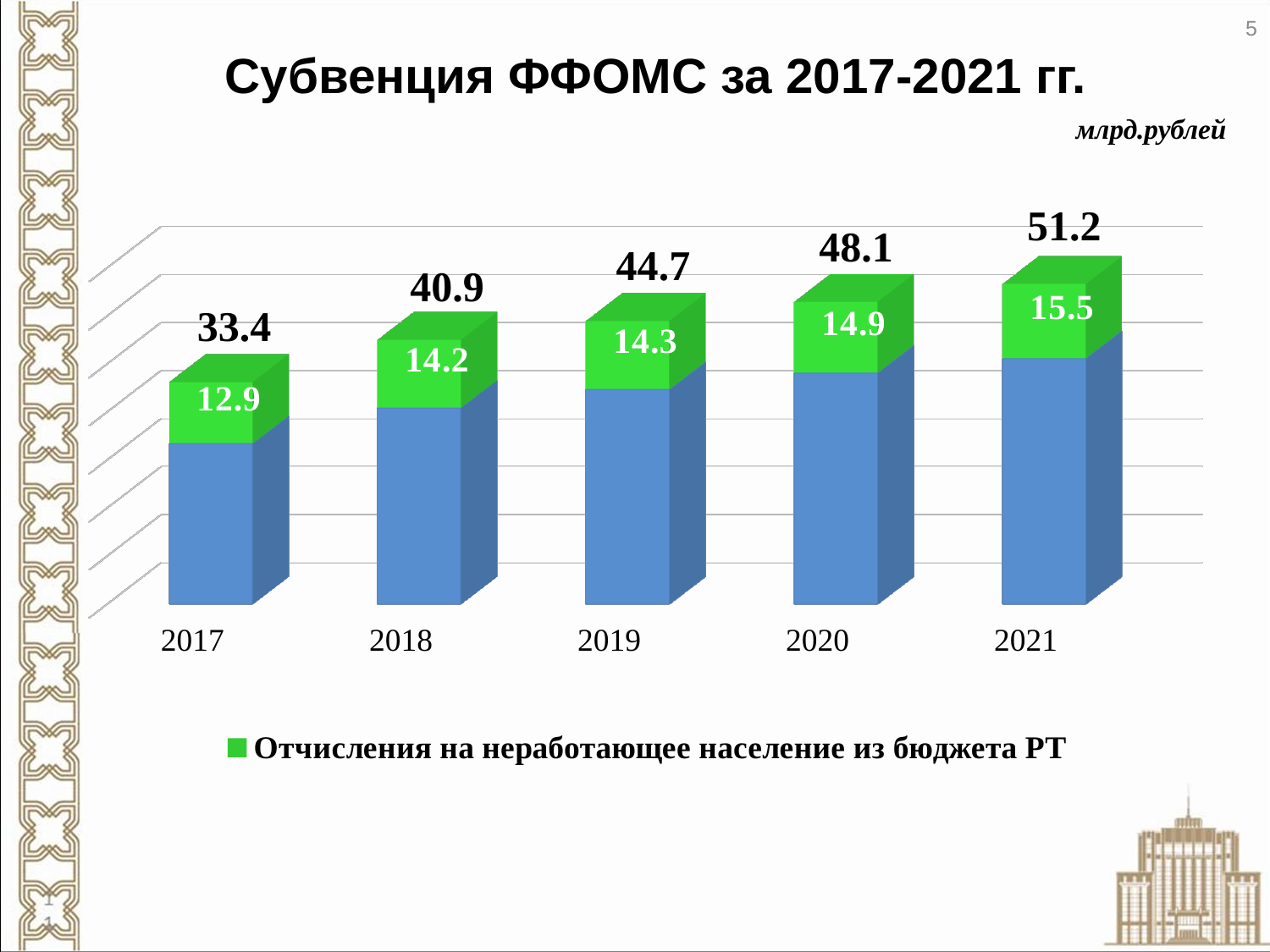
What is the value of the green segment (Отчисления на неработающее население из бюджета РТ) for 2019? 14.3 Which is larger: the total for 2018 or the total for 2019? 2019 What is the difference between the total values for 2021 and 2017? 17.8 What is the difference between the green segment values for 2021 and 2020? 0.6 How many years are shown on the x axis? 5 Which year has the lowest value for the green segment? 2017 What is the total value shown above the bar for 2017? 33.4 Do the total values rise or fall from 2017 to 2021? Rise Which year has the highest total value? 2021 What kind of chart is shown on the slide? Stacked bar chart What is the value of the green segment for 2020? 14.9 What is the total value shown above the bar for 2021? 51.2